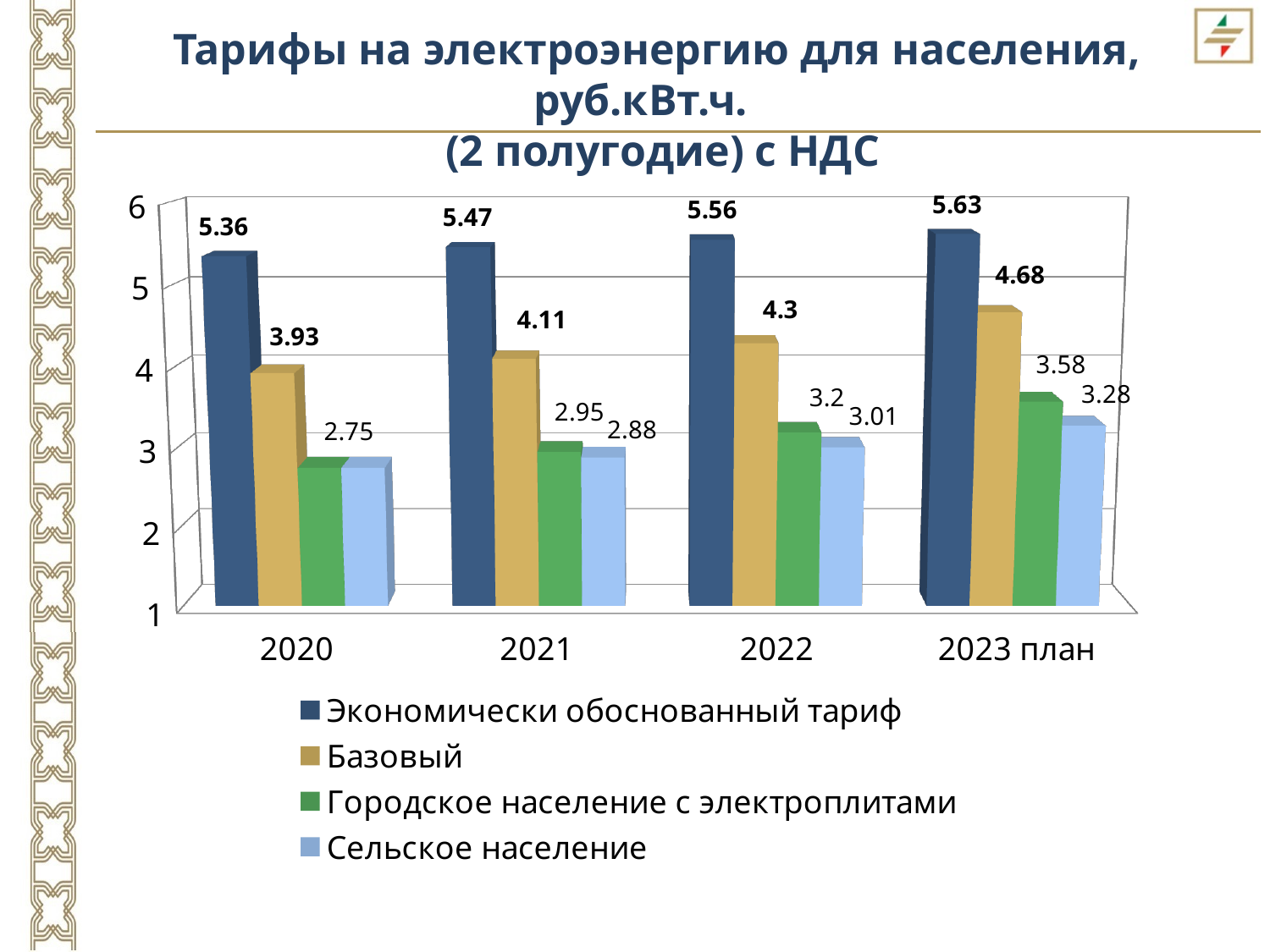
What is the difference between Экономически обоснованный тариф and Базовый in 2021? 1.36 Which is larger in 2023 план: Городское население с электроплитами or Сельское население? Городское население с электроплитами In which year is Экономически обоснованный тариф highest? 2023 план What type of chart is shown on the slide? bar chart What is the value of Экономически обоснованный тариф for 2022? 5.56 Does the value of Базовый rise or fall from 2020 to 2023 план? rise What is the value of Базовый for 2023 план? 4.68 What is the value of Сельское население for 2022? 3.01 How many series does the legend list? 4 What is the value of Городское население с электроплитами for 2021? 2.95 In which year is Базовый lowest? 2020 How many year categories are shown on the x axis? 4